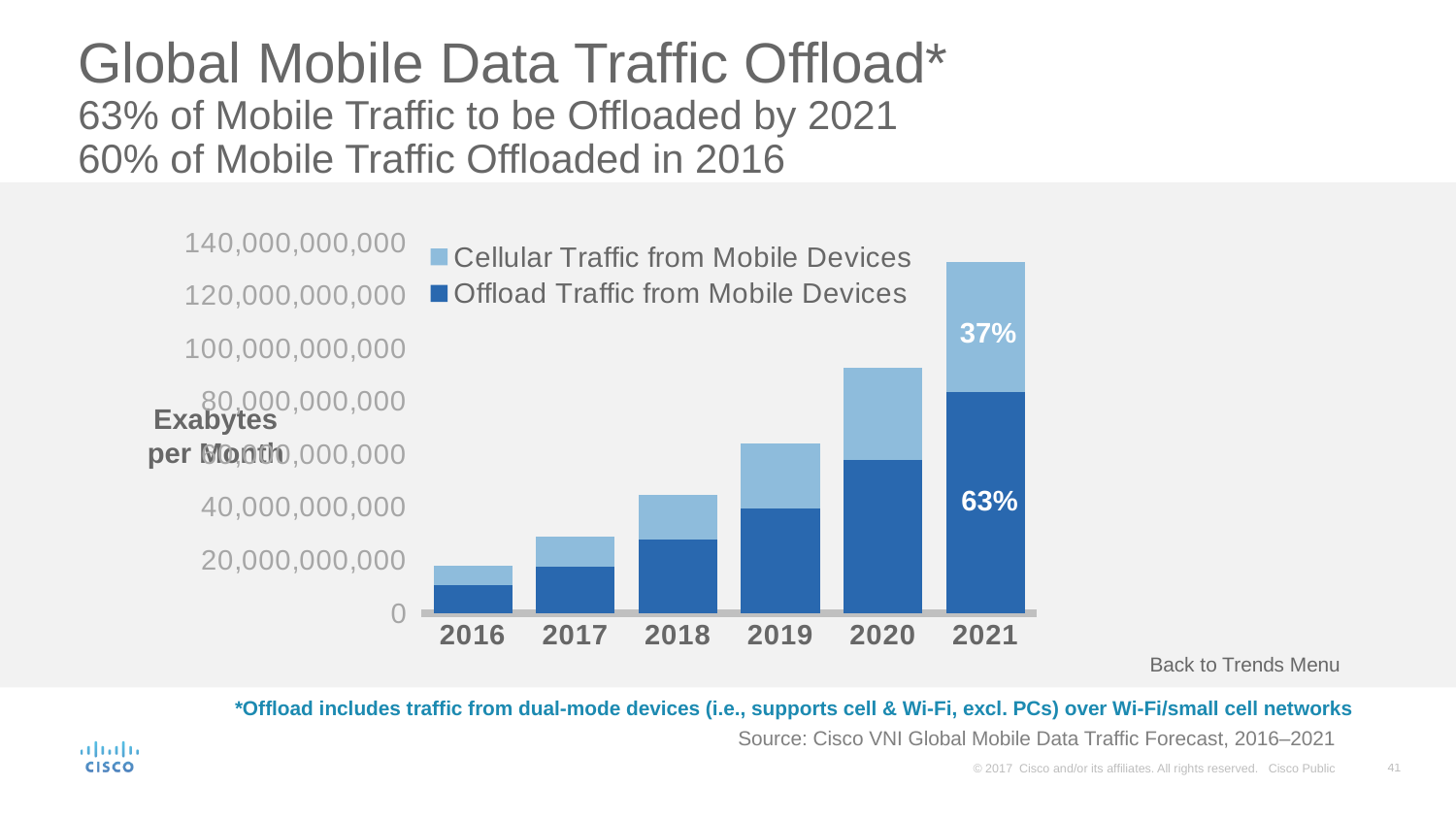
Which year has the shortest total bar? 2016 Do the total bar heights rise or fall from 2016 to 2021? Rise How many series does the legend list? 2 Is the total bar for 2021 greater or less than 120,000,000,000? greater Which year has the tallest total bar? 2021 Is the Offload Traffic from Mobile Devices value for 2020 greater or less than 40,000,000,000? greater How many years are shown on the x axis? 6 What percentage label is shown on the Cellular Traffic from Mobile Devices segment for 2021? 37% Which year has the larger total bar, 2019 or 2020? 2020 What kind of chart is shown on the slide? Stacked bar chart What percentage label is shown on the Offload Traffic from Mobile Devices segment for 2021? 63%